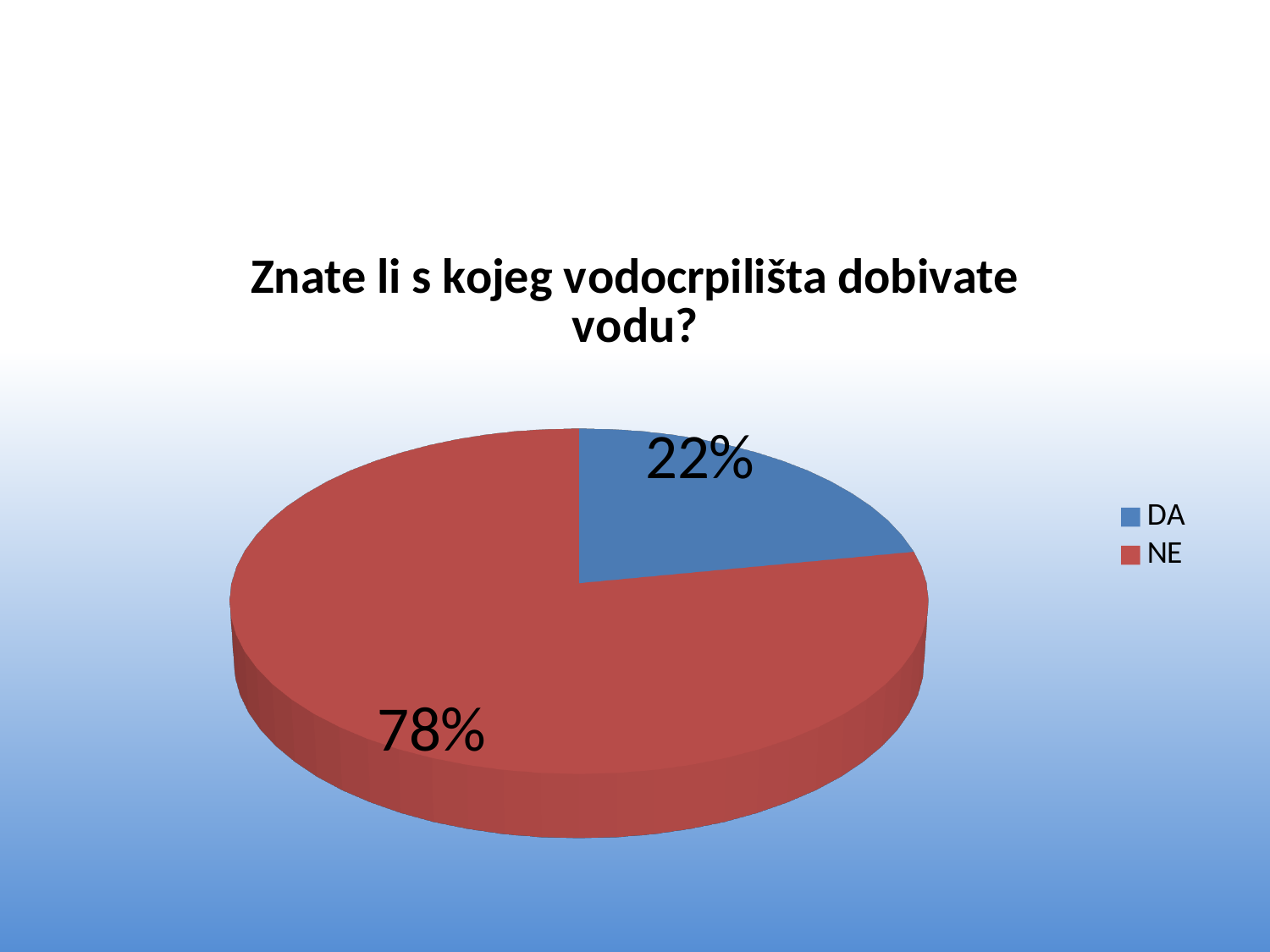
What is the title of the chart? Znate li s kojeg vodocrpilišta dobivate vodu? What kind of chart is shown on the slide? Pie chart How many categories are shown in the pie chart? 2 What colour is the NE slice of the pie? Red What is the difference in percentage points between the NE and DA slices? 56 Which category has the largest slice of the pie? NE Which slice is larger, DA or NE? NE What share of the pie does the DA slice represent? 22% Which category has the smallest slice of the pie? DA What share of the pie does the NE slice represent? 78%